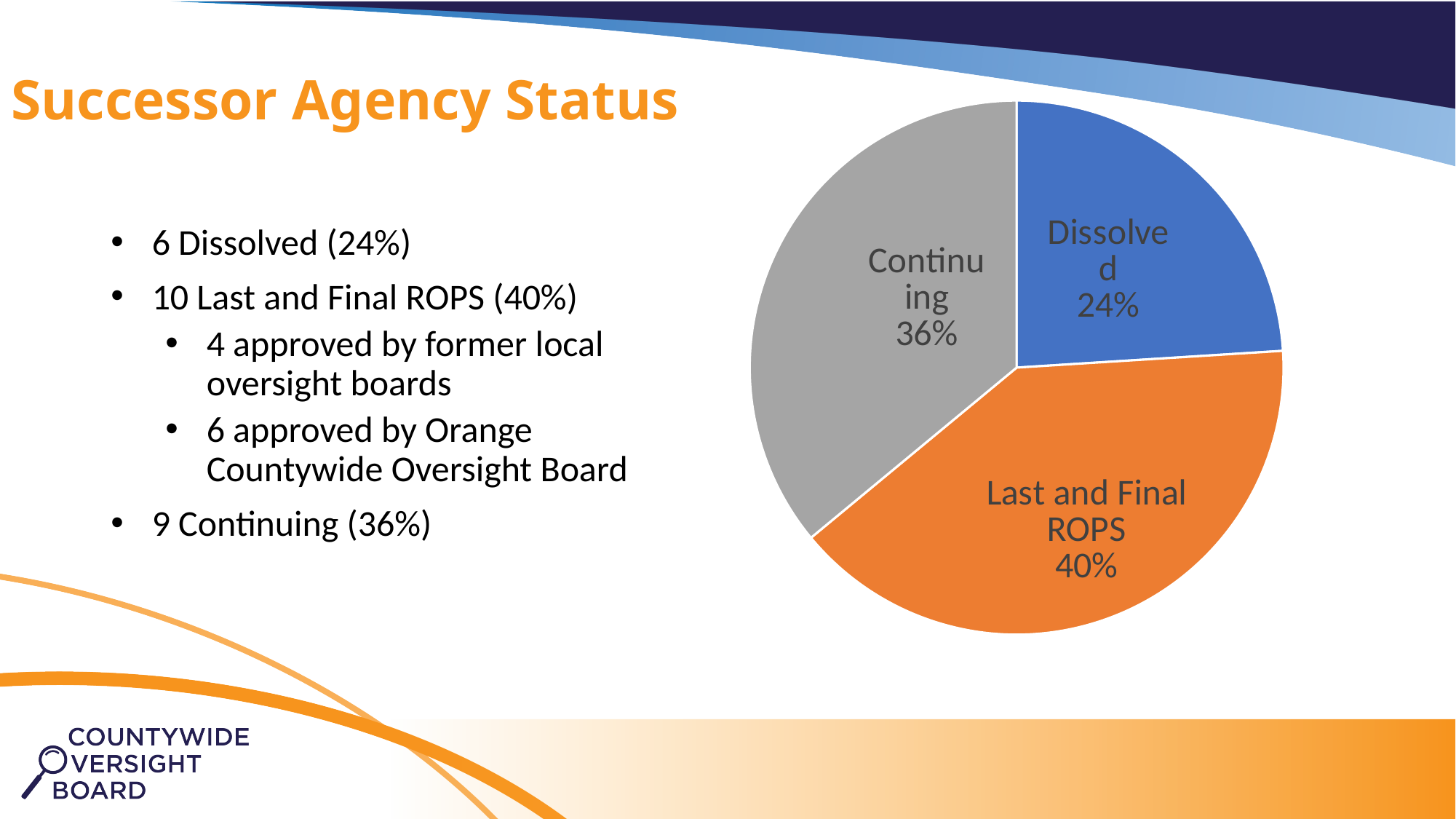
What share of the pie does the Continuing slice represent? 36% What share of the pie does the Last and Final ROPS slice represent? 40% Which slice of the pie chart is the largest? Last and Final ROPS What kind of chart is shown on the slide? pie chart What colour is the Continuing slice? grey Which is larger, the Continuing slice or the Dissolved slice? Continuing What share of the pie does the Dissolved slice represent? 24% What colour is the Last and Final ROPS slice? orange Which slice of the pie chart is the smallest? Dissolved What is the difference in percentage points between the Continuing slice and the Dissolved slice? 12 How many slices does the pie chart have? 3 What is the difference in percentage points between the Last and Final ROPS slice and the Dissolved slice? 16